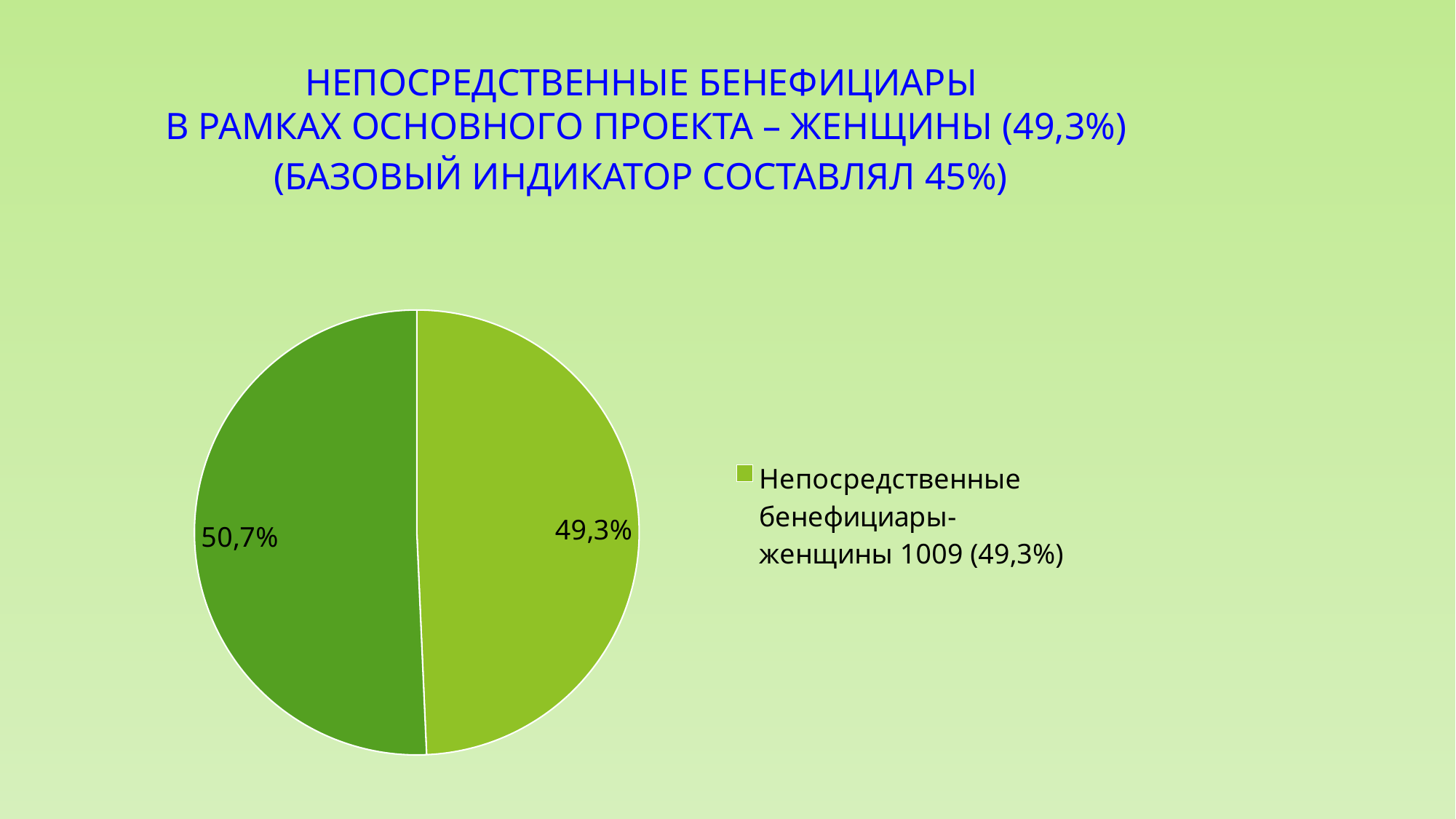
What is the difference in percentage points between the two slices of the pie chart? 1,4 What is the largest slice of the pie chart? 50,7% What percentage is shown on the darker green slice of the pie chart? 50,7% What share of the pie is labelled for the slice 'Непосредственные бенефициары-женщины'? 49,3% What colour is the slice labelled 49,3%? Light green What baseline indicator value is stated in the slide title? 45% Which slice is larger: the one labelled 50,7% or the one labelled 49,3%? 50,7% What number of women beneficiaries is given in the legend entry? 1009 What kind of chart is shown on the slide? Pie chart Is the share of the slice for women beneficiaries greater or less than 50%? less How many slices does the pie chart have? 2 How many entries does the legend of the pie chart list? 1